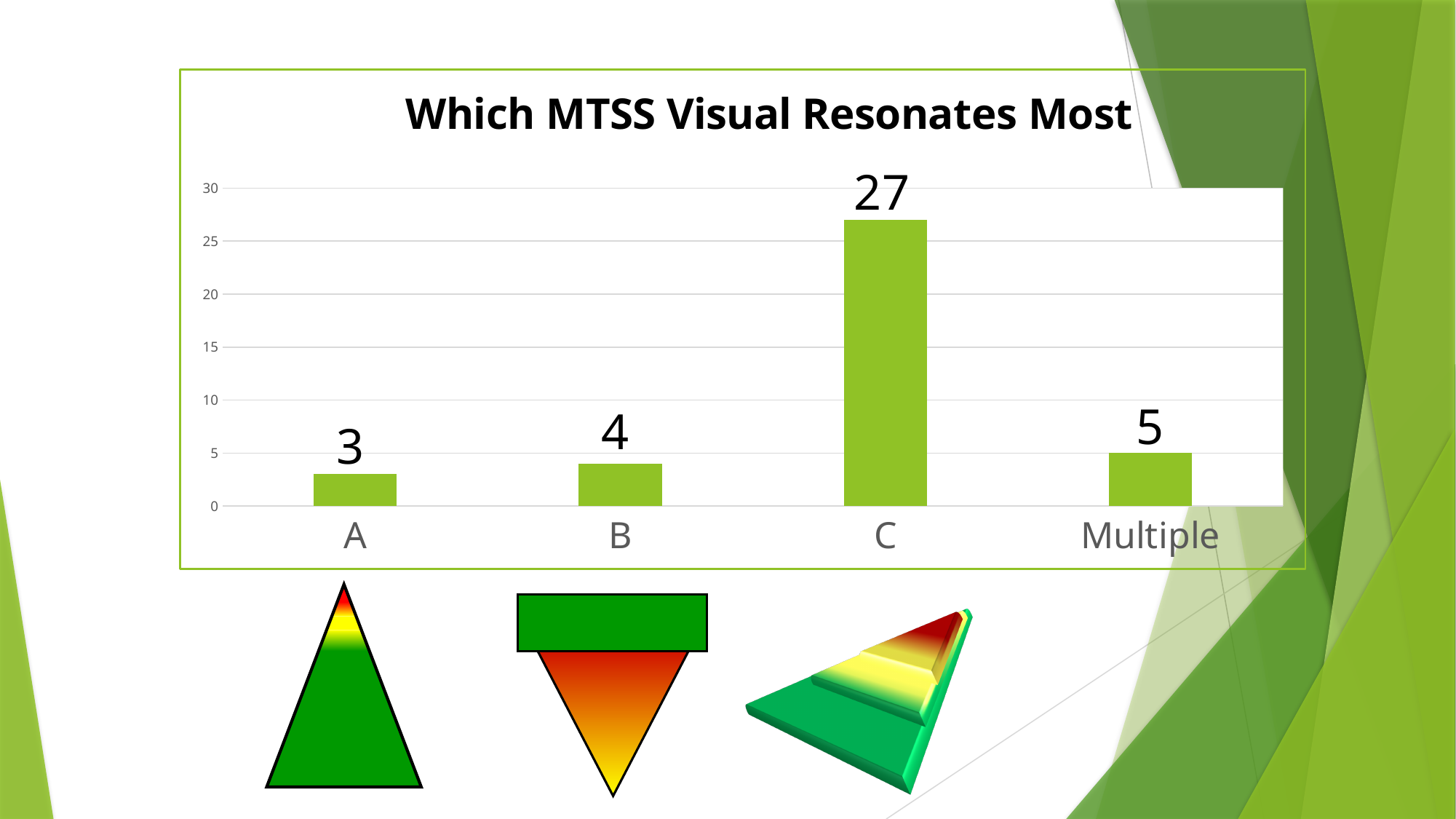
Which is larger, the value for B or the value for Multiple? Multiple What is the value for Multiple? 5 How many categories are shown on the x axis? 4 Which category has the lowest value? A What kind of chart is this? bar chart What is the value for A? 3 What is the difference between the values for C and Multiple? 22 Is the value for C greater or less than 25? greater What is the difference between the values for B and A? 1 Which category has the highest value? C What is the value for C? 27 What is the title of the chart? Which MTSS Visual Resonates Most